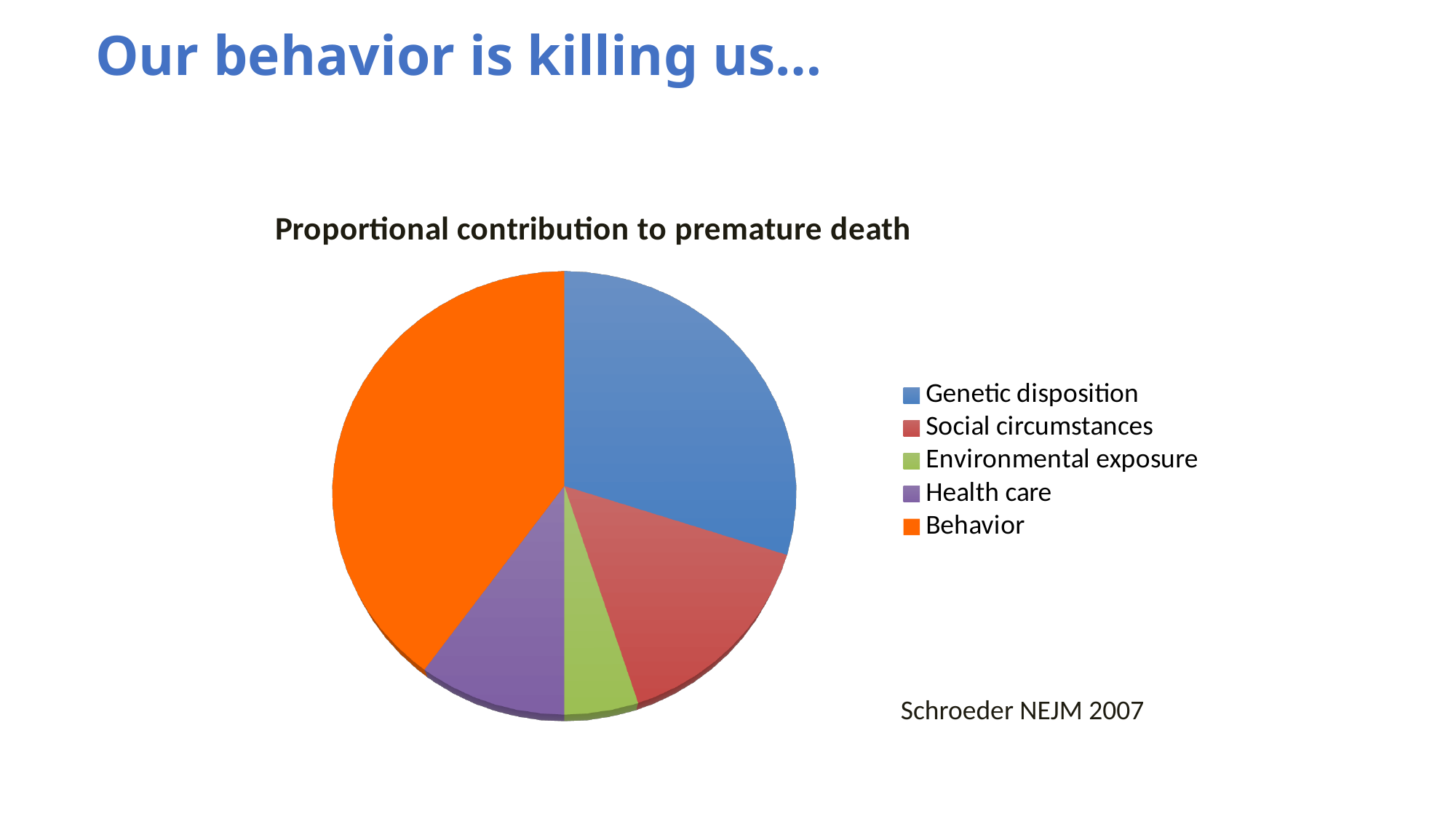
Which category has the smallest slice of the pie? Environmental exposure What is the title of the chart? Proportional contribution to premature death How many categories does the pie chart show? 5 Which slice is larger, Social circumstances or Health care? Social circumstances Which slice is larger, Behavior or Genetic disposition? Behavior Which category has the largest slice of the pie? Behavior What colour is the Behavior slice in the pie chart? Orange Which slice is larger, Health care or Environmental exposure? Health care How many entries does the legend list? 5 What kind of chart is shown on the slide? Pie chart Which category is the second largest slice of the pie? Genetic disposition